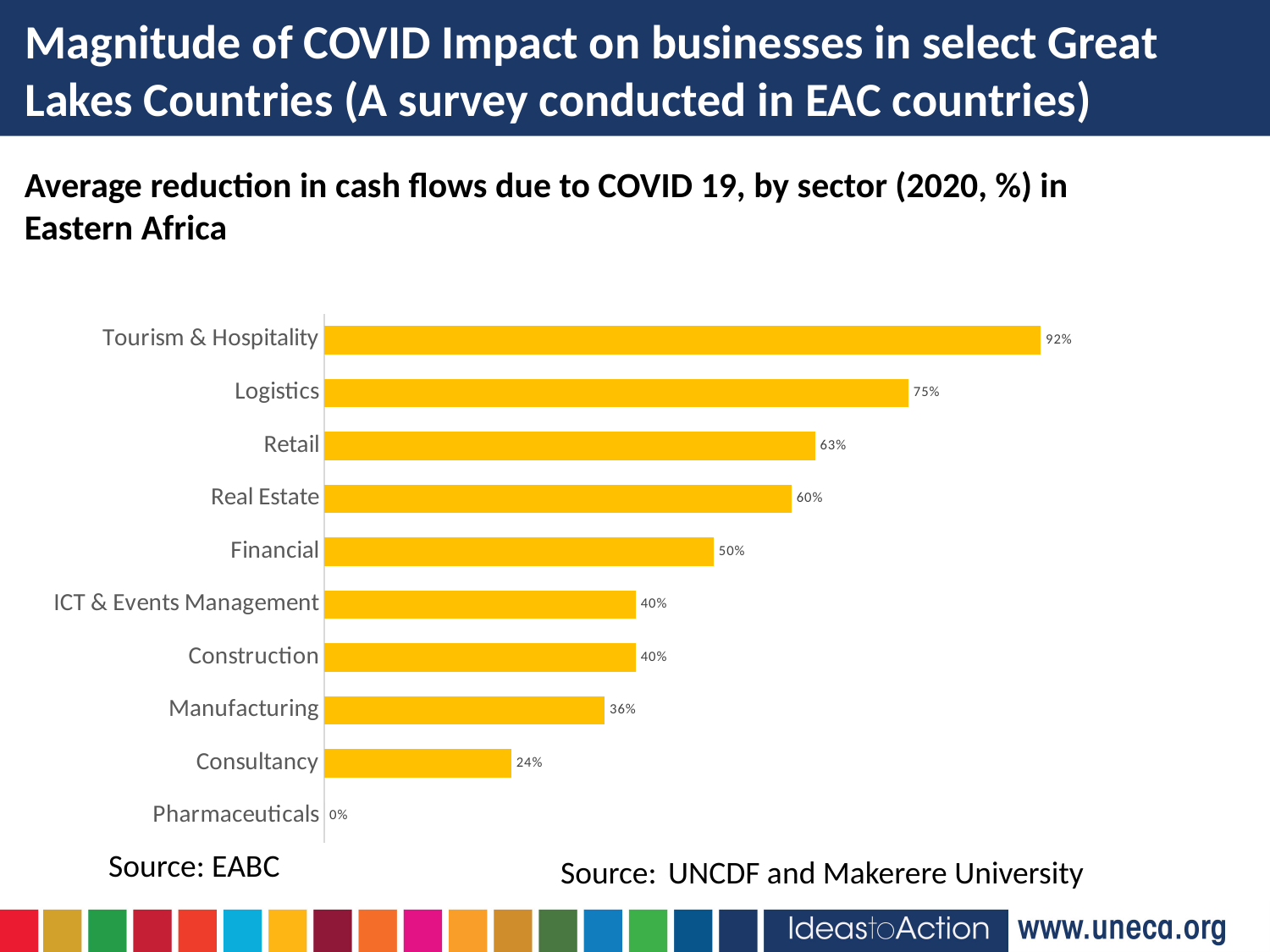
What is the value shown for Manufacturing? 36% How many sectors are shown in the chart? 10 What kind of chart is shown on the slide? Bar chart What is the difference between the values for Retail and Real Estate? 3% Which is larger, the value for Financial or the value for Construction? Financial Which sector has the lowest average reduction in cash flows? Pharmaceuticals What is the value shown for Logistics? 75% Which sector has the highest average reduction in cash flows? Tourism & Hospitality What is the difference between the values for Logistics and Consultancy? 51% What is the average reduction in cash flows for Tourism & Hospitality? 92% What is the value shown for Pharmaceuticals? 0% What colour are the bars in the chart? Yellow